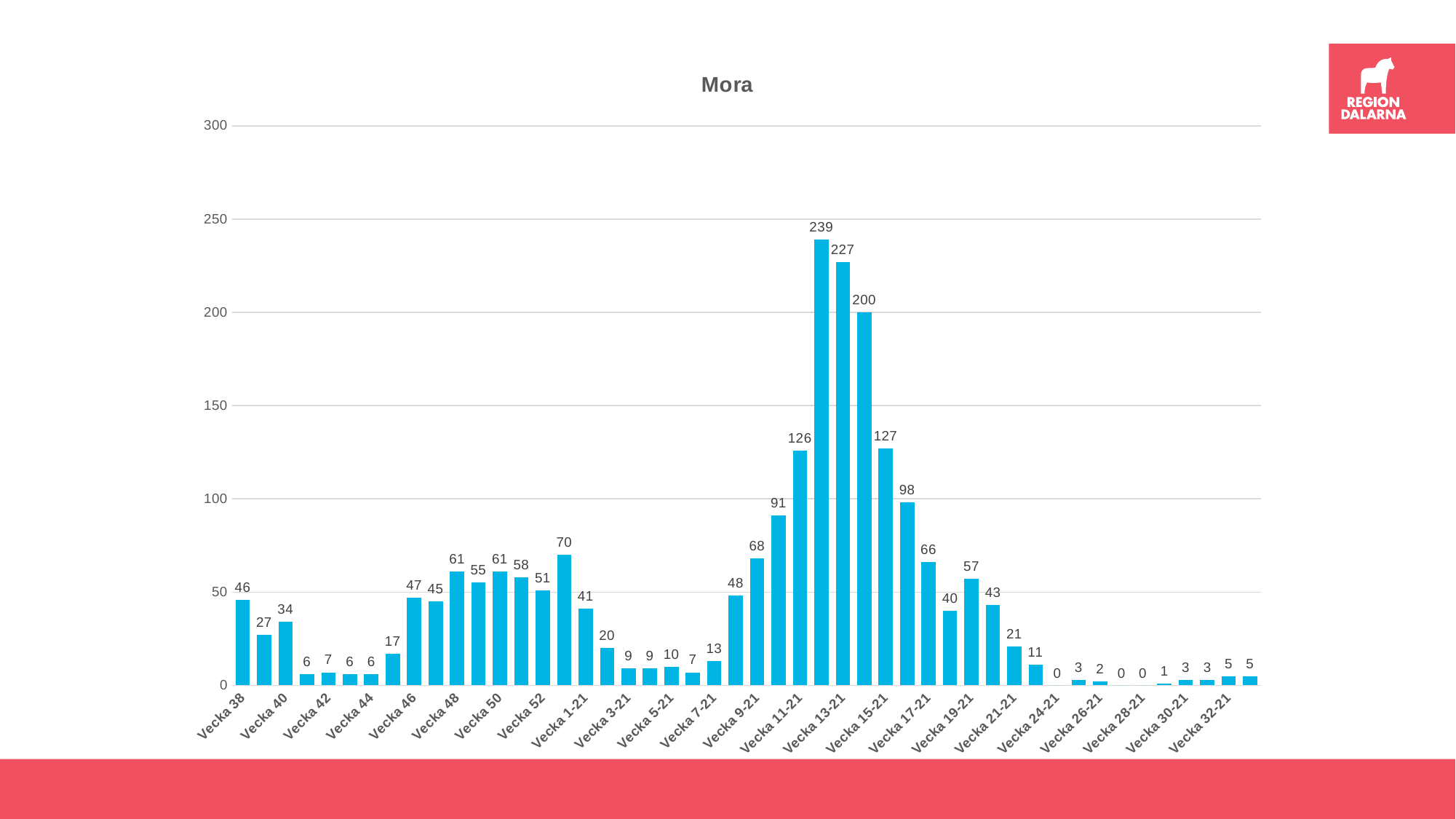
What is the value for Vecka 24-21? 0 Do the values rise or fall from Vecka 21-21 to Vecka 24-21? fall What is the difference between the values for Vecka 15-21 and Vecka 9-21? 59 What is the value for Vecka 13-21? 227 What is the value for Vecka 11-21? 126 What kind of chart is shown on the slide? bar chart What is the value for Vecka 38? 46 Is the value for Vecka 13-21 greater or less than 200? greater What is the highest value shown on the chart? 239 Which has a larger value, Vecka 48 or Vecka 52? Vecka 48 What is the title of the chart? Mora What is the difference between the values for Vecka 46 and Vecka 44? 41